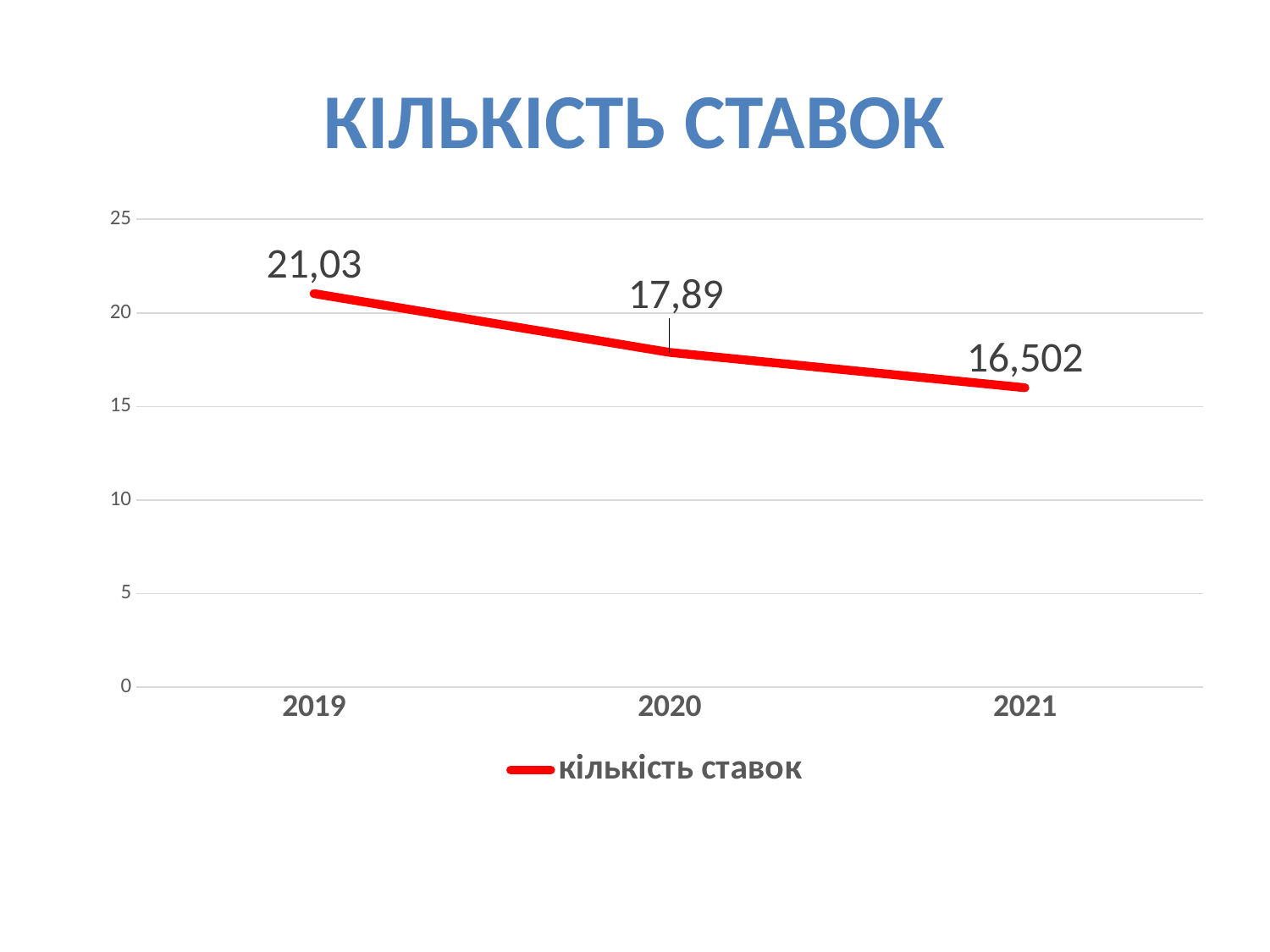
Which year has the lowest value? 2021 Do the values rise or fall from 2019 to 2021? fall What is the difference between the values for 2019 and 2020? 3,14 How many years are plotted on the chart? 3 What kind of chart is shown on the slide? line chart What is the difference between the values for 2019 and 2021? 4,528 Which year has the highest value? 2019 What is the value for 2021? 16,502 Is the value for 2019 greater or less than 20? greater What is the value for 2020? 17,89 Which is larger, the value for 2020 or the value for 2021? 2020 What is the value for 2019? 21,03